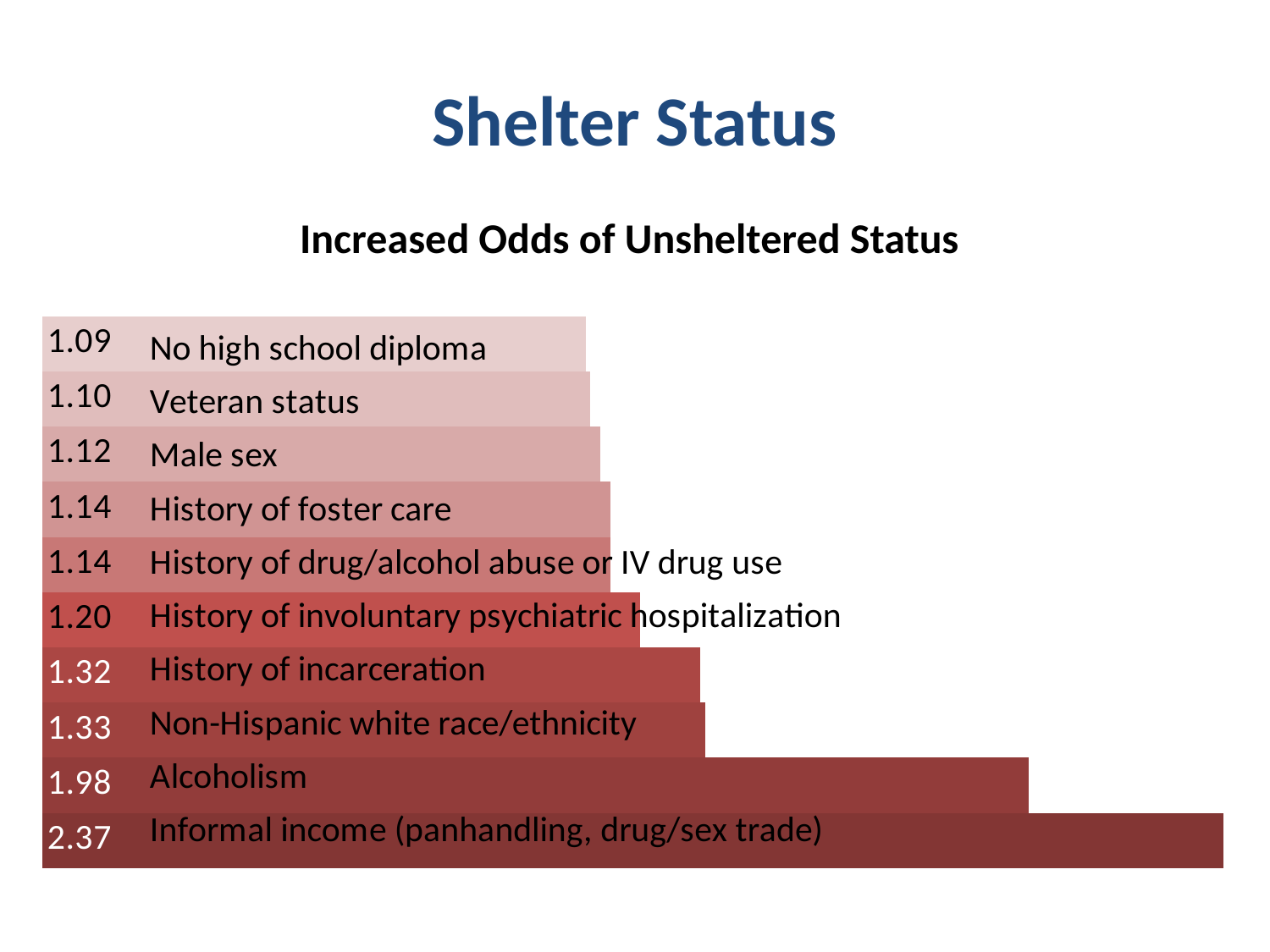
What is the increased odds value for History of incarceration? 1.32 What is the title of the chart? Increased Odds of Unsheltered Status How many categories are shown in the chart? 10 What is the difference between the values for Non-Hispanic white race/ethnicity and Male sex? 0.21 What is the difference between the values for Informal income (panhandling, drug/sex trade) and Alcoholism? 0.39 Which category has the highest increased odds of unsheltered status? Informal income (panhandling, drug/sex trade) What is the increased odds value for Alcoholism? 1.98 What is the increased odds value for Veteran status? 1.10 What kind of chart is shown on the slide? Bar chart Which category has the lowest increased odds of unsheltered status? No high school diploma Which has a larger value, History of involuntary psychiatric hospitalization or History of foster care? History of involuntary psychiatric hospitalization Which has a larger value, Alcoholism or History of incarceration? Alcoholism